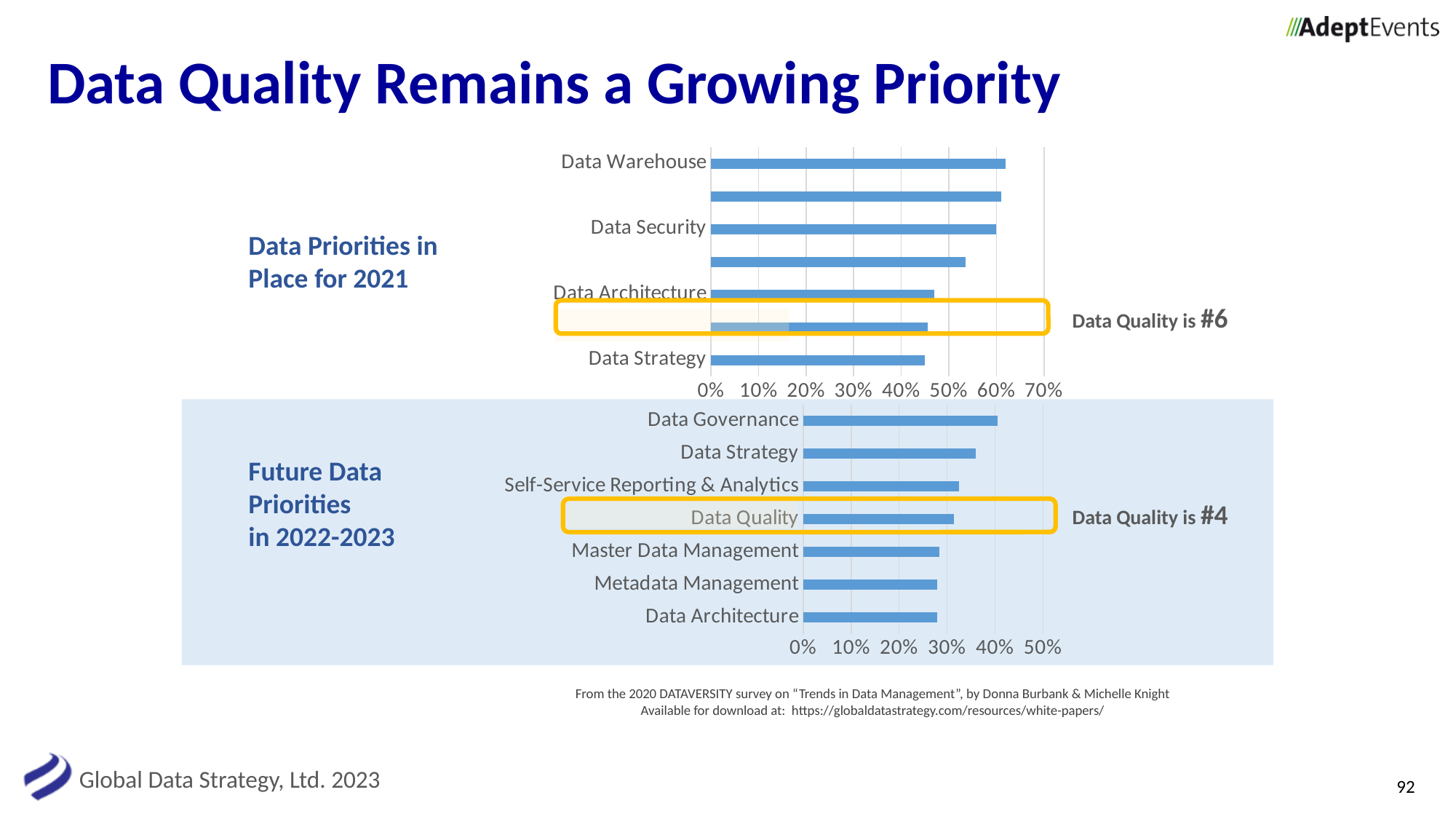
In the 'Data Priorities in Place for 2021' chart, is the value for Data Strategy greater or less than 50%? less In the 'Future Data Priorities in 2022-2023' chart, is the value for Data Strategy greater or less than 30%? greater In the 'Data Priorities in Place for 2021' chart, is the value for Data Warehouse greater or less than 50%? greater According to the slide, what rank does Data Quality hold in the 'Future Data Priorities in 2022-2023' chart? #4 In the 'Future Data Priorities in 2022-2023' chart, which category has the highest value? Data Governance In the 'Data Priorities in Place for 2021' chart, which is larger: Data Warehouse or Data Architecture? Data Warehouse What kind of chart is the 'Future Data Priorities in 2022-2023' chart? bar chart In the 'Future Data Priorities in 2022-2023' chart, which is larger: Data Strategy or Metadata Management? Data Strategy In the 'Future Data Priorities in 2022-2023' chart, how many categories are plotted? 7 According to the slide, what rank does Data Quality hold in the 'Data Priorities in Place for 2021' chart? #6